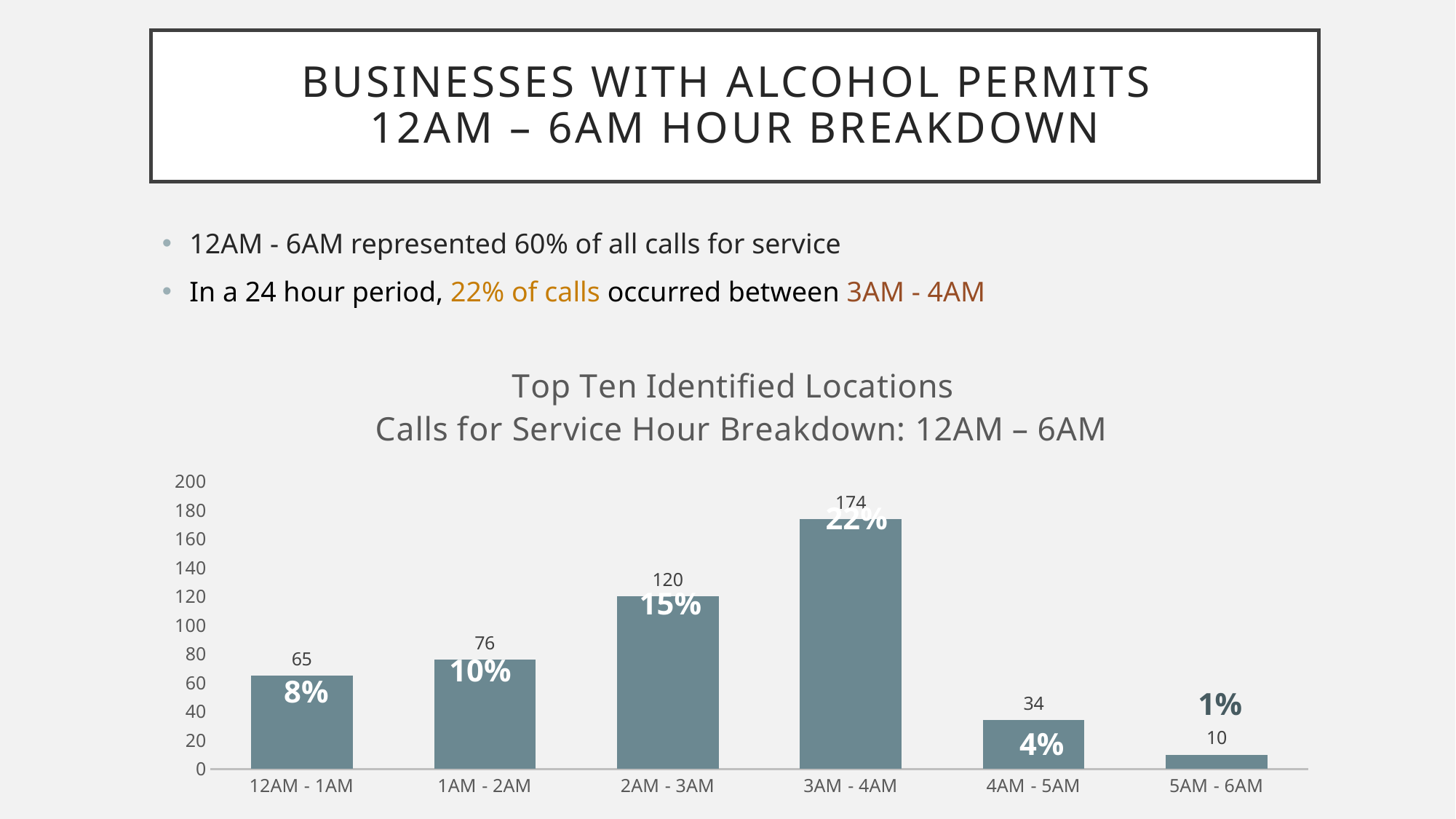
Do the values rise or fall from 3AM - 4AM to 5AM - 6AM? Fall What is the value for 3AM - 4AM? 174 What percentage label is shown on the 2AM - 3AM bar? 15% Which hour has the highest number of calls for service? 3AM - 4AM What is the title of the chart? Top Ten Identified Locations Calls for Service Hour Breakdown: 12AM – 6AM Which hour has the lowest number of calls for service? 5AM - 6AM What is the value for 5AM - 6AM? 10 How many hour categories are shown on the x axis? 6 What is the difference between the values for 3AM - 4AM and 2AM - 3AM? 54 Which is larger, the value for 1AM - 2AM or the value for 4AM - 5AM? 1AM - 2AM What is the value for 12AM - 1AM? 65 What kind of chart is shown on the slide? Bar chart